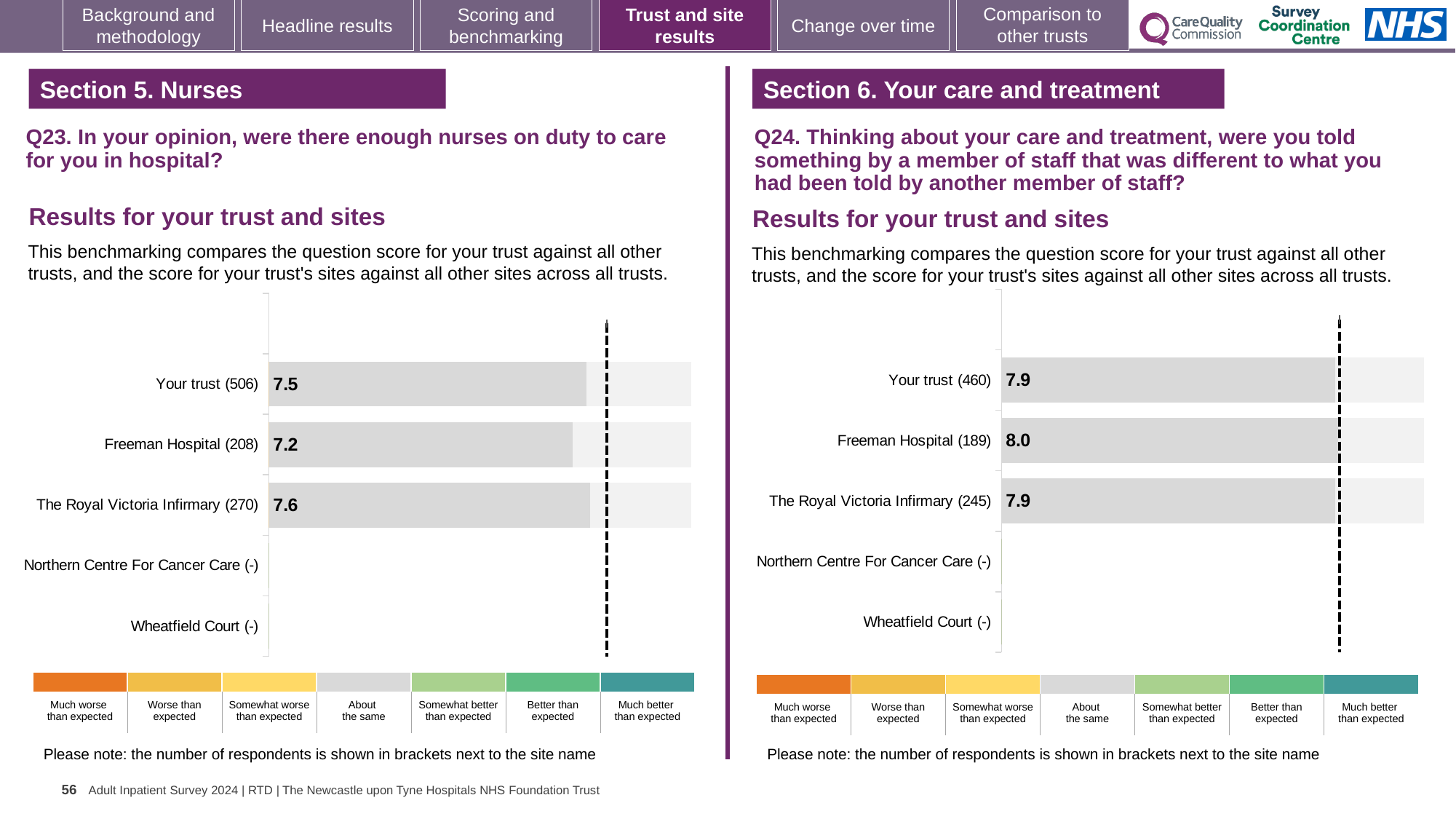
On the Q23 chart (left), how many site rows are listed on the vertical axis? 5 On the Q24 chart (right), what is the score for The Royal Victoria Infirmary? 7.9 On the Q23 chart (left), what is the score for Your trust? 7.5 On the Q23 chart (left), what is the difference between the scores for The Royal Victoria Infirmary and Freeman Hospital? 0.4 On the Q23 chart (left), which site has the highest score? The Royal Victoria Infirmary What type of chart is used on the Q24 chart (right)? Bar chart On the Q23 chart (left), what is the score for Freeman Hospital? 7.2 On the Q23 chart (left), which site has the lowest score among those with a plotted bar? Freeman Hospital On the Q23 chart (left), how many respondents are shown in brackets for Your trust? 506 On the Q24 chart (right), what is the score for Freeman Hospital? 8.0 On the Q24 chart (right), what is the difference between the scores for Freeman Hospital and Your trust? 0.1 On the Q24 chart (right), which site has the highest score? Freeman Hospital